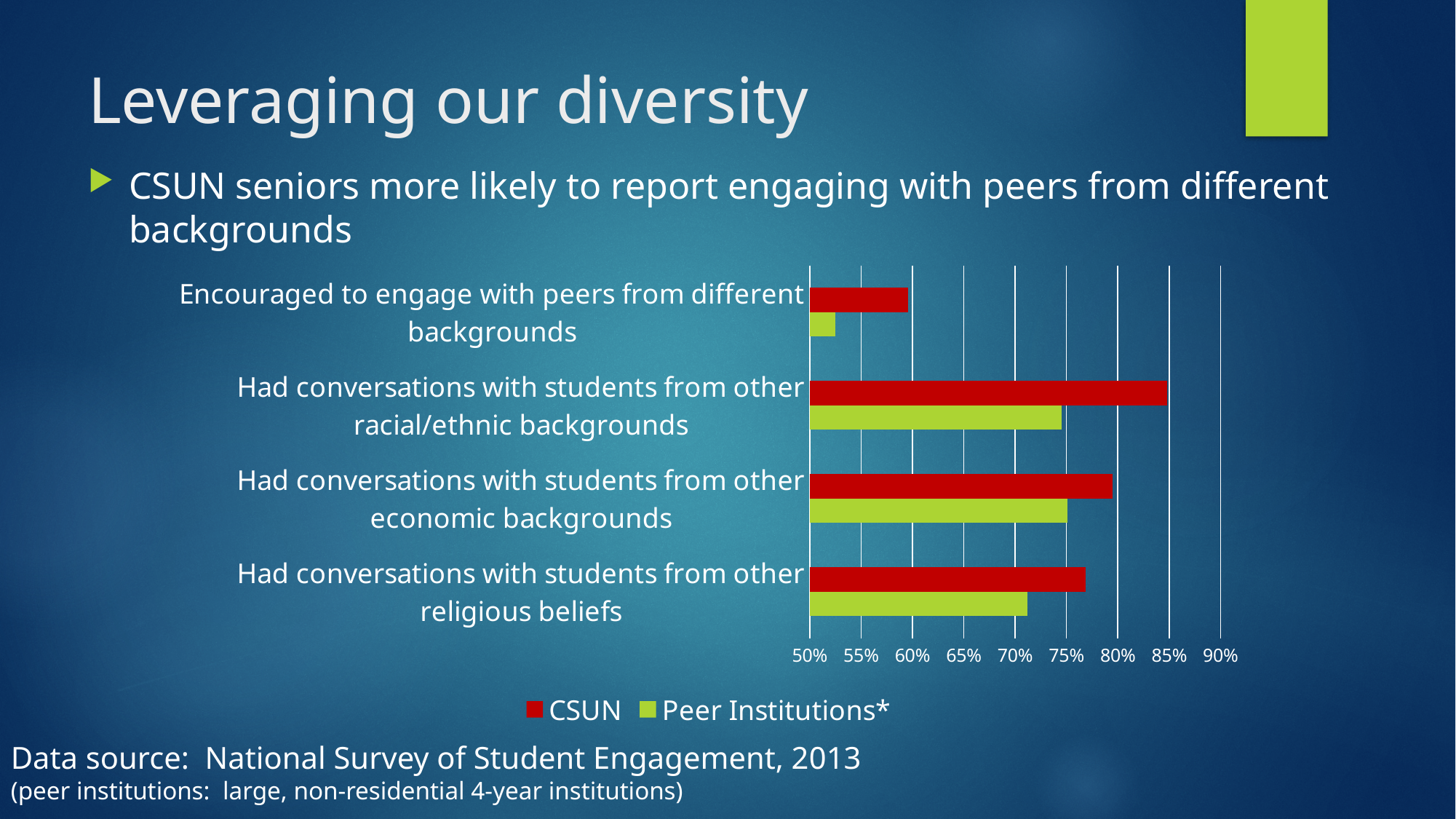
How many categories are plotted on the chart? 4 Is the Peer Institutions* value for 'Had conversations with students from other religious beliefs' greater or less than 75%? less How many series does the chart legend list? 2 For 'Had conversations with students from other economic backgrounds', which series has the larger value, CSUN or Peer Institutions*? CSUN What kind of chart is shown on the slide? bar chart Which category has the lowest CSUN value? Encouraged to engage with peers from different backgrounds Which series is shown in red on the chart? CSUN Is the Peer Institutions* value for 'Encouraged to engage with peers from different backgrounds' greater or less than 55%? less Which category has the highest CSUN value? Had conversations with students from other racial/ethnic backgrounds Is the CSUN value for 'Had conversations with students from other racial/ethnic backgrounds' greater or less than 80%? greater Which category has the lowest Peer Institutions* value? Encouraged to engage with peers from different backgrounds